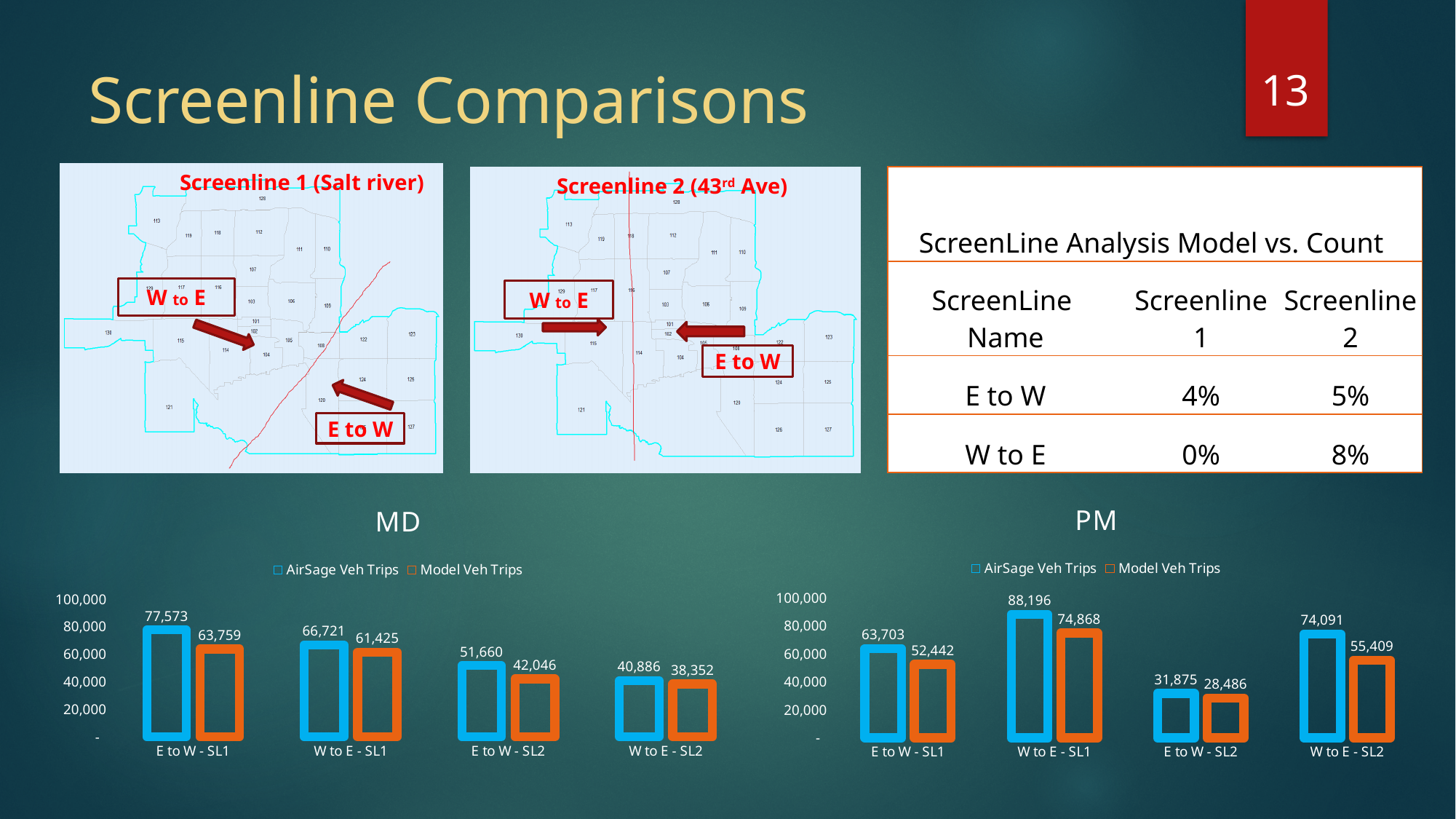
In the PM chart, which is larger for E to W - SL1: AirSage Veh Trips or Model Veh Trips? AirSage Veh Trips In the MD chart, what colour are the Model Veh Trips bars? orange In the MD chart, is the Model Veh Trips value for E to W - SL2 greater or less than 60,000? less In the MD chart, what is the difference between AirSage Veh Trips and Model Veh Trips for W to E - SL2? 2,534 In the MD chart, what is the AirSage Veh Trips value for E to W - SL1? 77,573 In the MD chart, which category has the highest AirSage Veh Trips value? E to W - SL1 In the PM chart, what is the difference between AirSage Veh Trips and Model Veh Trips for W to E - SL2? 18,682 In the PM chart, which category has the lowest Model Veh Trips value? E to W - SL2 What kind of chart is the PM chart? bar chart How many series does the legend of the MD chart list? 2 In the PM chart, what is the Model Veh Trips value for W to E - SL1? 74,868 How many categories are shown on the x axis of the PM chart? 4